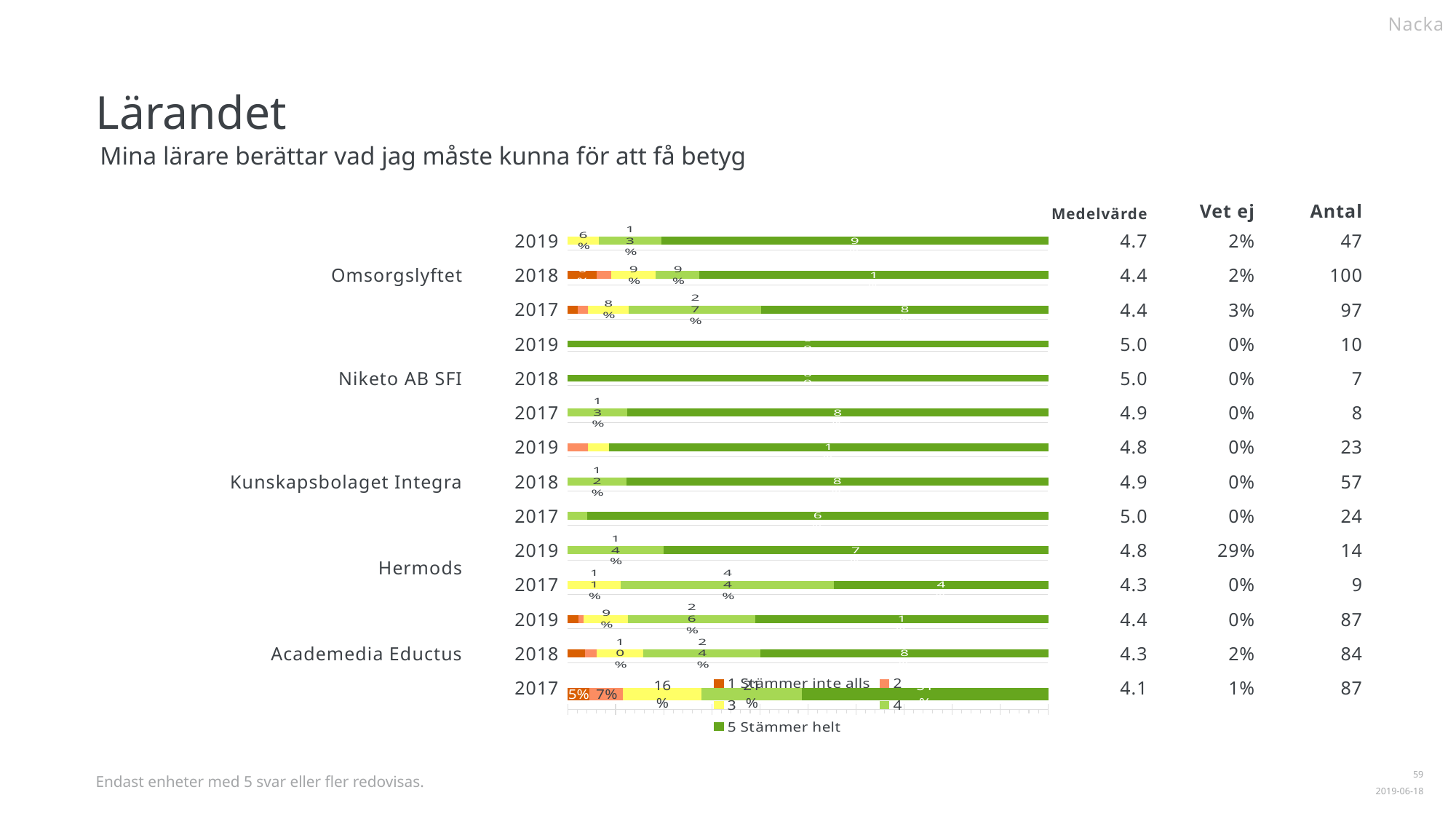
What is the Vet ej percentage for Hermods in 2019? 29% In the Academedia Eductus 2017 bar, which is larger: the share for category 2 or the share for category 3? Category 3 What kind of chart is shown on the slide? Stacked bar chart In the Omsorgslyftet 2019 bar, what percentage is shown for category 3 (yellow)? 6% What is the legend label for the dark green series? 5 Stämmer helt In the Academedia Eductus 2017 bar, what percentage is shown for category 2? 7% How many series does the chart legend list? 5 In the Academedia Eductus 2017 bar, what percentage is shown for '1 Stämmer inte alls'? 5% What is the Antal for Omsorgslyftet in 2018? 100 In the Hermods 2017 bar, what percentage is shown for category 4? 44% What is the Medelvärde for Omsorgslyftet in 2019? 4.7 How many bars (unit-year rows) are plotted in the chart? 14